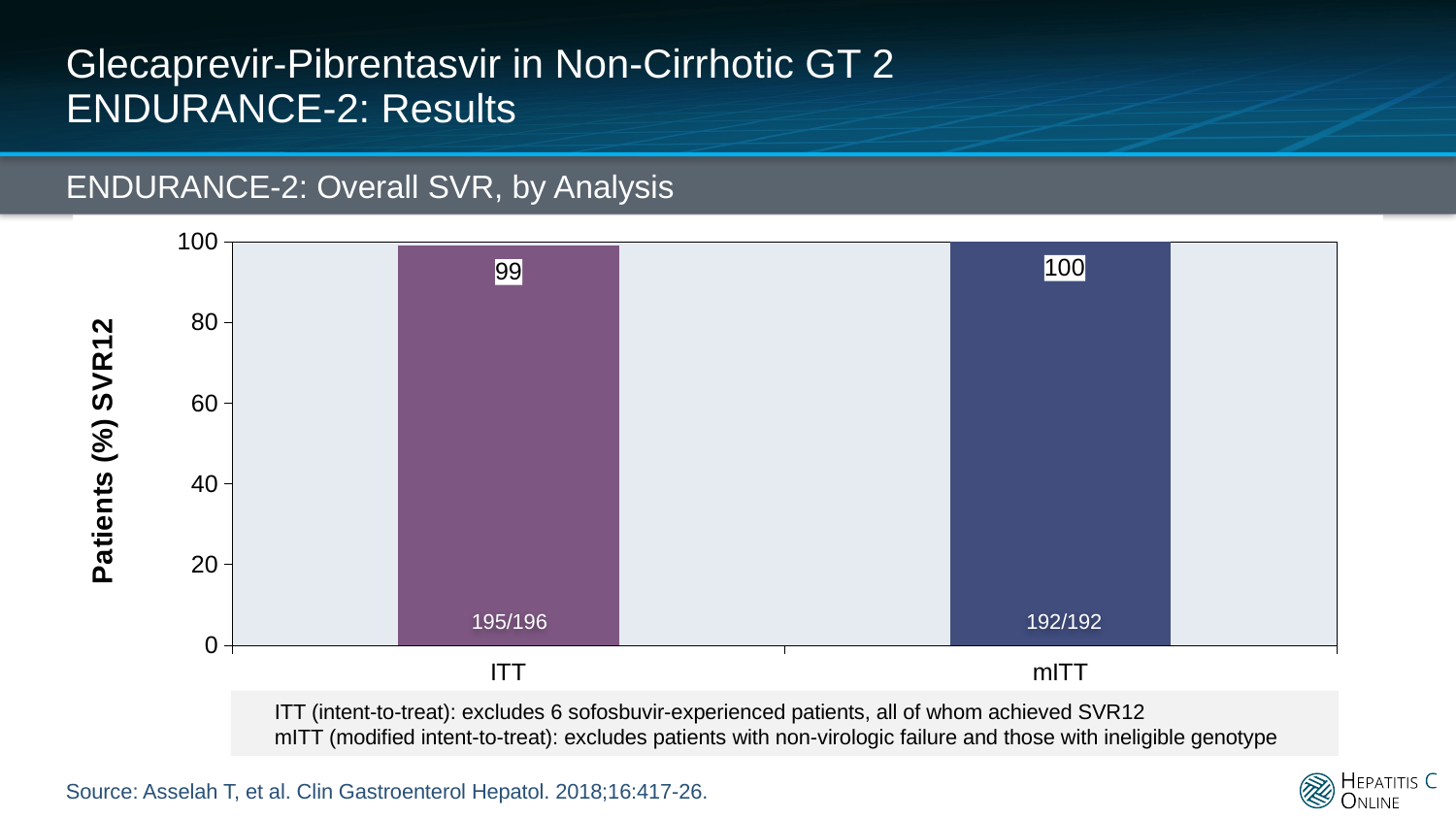
What is the title of the chart? ENDURANCE-2: Overall SVR, by Analysis Which analysis has the higher SVR12 rate? mITT Which analysis has the lower SVR12 rate? ITT How many analysis categories are shown on the x axis? 2 What fraction of patients achieved SVR12 in the ITT analysis? 195/196 What fraction of patients achieved SVR12 in the mITT analysis? 192/192 Is the SVR12 rate for ITT greater or less than 80? greater What is the label of the y axis? Patients (%) SVR12 What is the SVR12 rate (%) for the mITT analysis? 100 What is the difference in SVR12 rate (%) between mITT and ITT? 1 What is the SVR12 rate (%) for the ITT analysis? 99 What kind of chart is shown on the slide? Bar chart